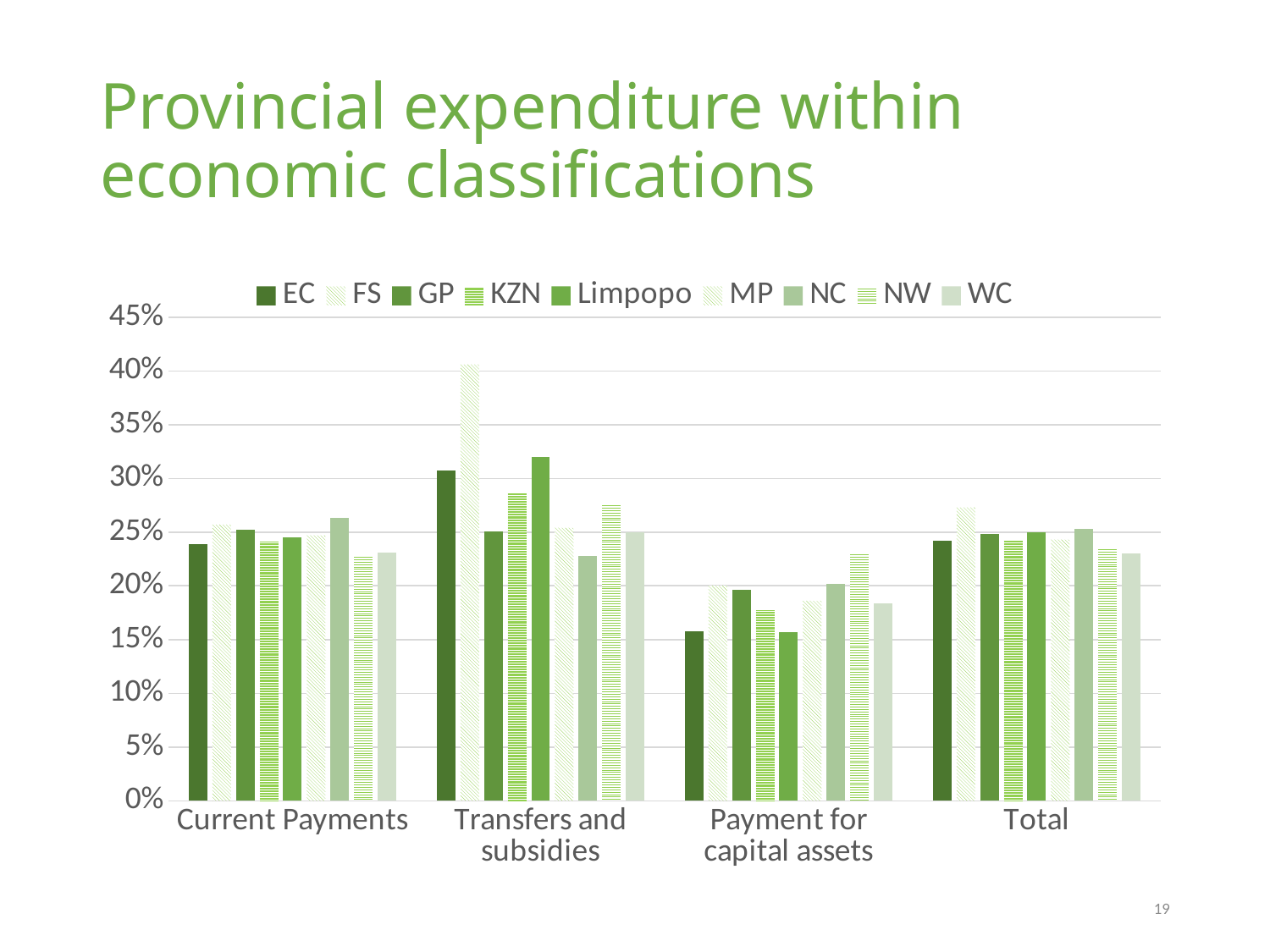
For EC, which is larger: Transfers and subsidies or Current Payments? Transfers and subsidies How many categories are shown on the x axis? 4 In Transfers and subsidies, which is larger: Limpopo or GP? Limpopo Is the value for EC in Payment for capital assets greater or less than 20%? less Which province has the highest value for Transfers and subsidies? FS Which province has the highest value in the Total category? FS Is the value for FS in Transfers and subsidies greater or less than 35%? greater What is the title of the slide? Provincial expenditure within economic classifications Is the value for NC in Transfers and subsidies greater or less than 25%? less What kind of chart is shown on the slide? bar chart Which province has the highest value for Payment for capital assets? NW How many series does the legend list? 9